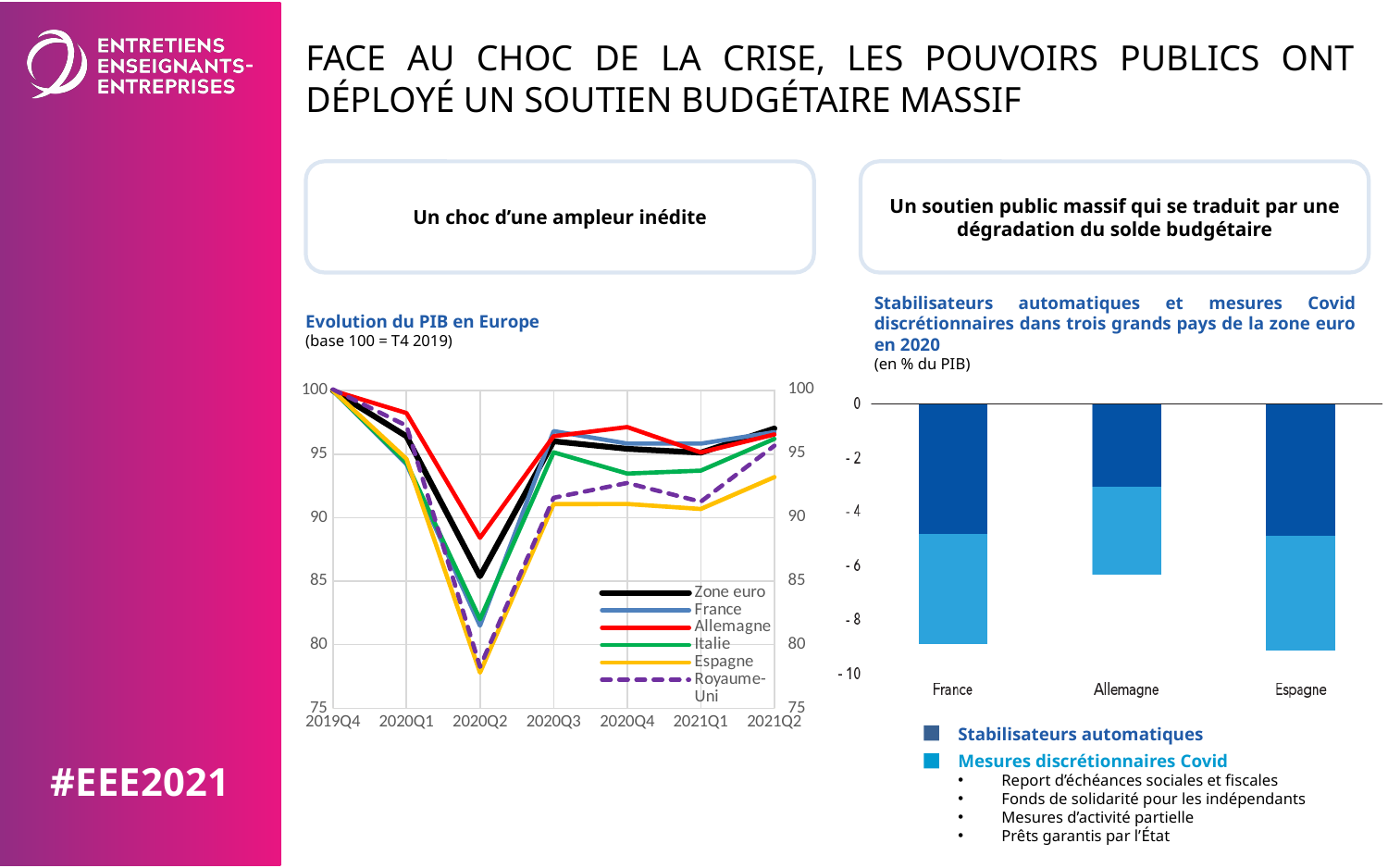
In the 'Evolution du PIB en Europe' chart, is the value for Italie at 2020Q2 greater or less than 85? less How many countries are shown in the 'Stabilisateurs automatiques et mesures Covid discrétionnaires' bar chart? 3 How many quarters are shown on the x axis of the 'Evolution du PIB en Europe' chart? 7 What kind of chart is 'Evolution du PIB en Europe'? line chart What kind of chart is the one on the right about 'Stabilisateurs automatiques et mesures Covid discrétionnaires'? bar chart In the 'Stabilisateurs automatiques et mesures Covid discrétionnaires' bar chart, which country has the shortest total bar? Allemagne In the 'Evolution du PIB en Europe' chart, is the value for Espagne at 2021Q2 greater or less than 95? less In the 'Evolution du PIB en Europe' chart, what is the value of all series at 2019Q4? 100 How many series does the legend of the 'Evolution du PIB en Europe' chart list? 6 In the 'Evolution du PIB en Europe' chart, do the values rise or fall between 2019Q4 and 2020Q2? fall How many series does the legend of the 'Stabilisateurs automatiques et mesures Covid discrétionnaires' bar chart list? 2 In the 'Evolution du PIB en Europe' chart, which series has the highest value at 2020Q2? Allemagne